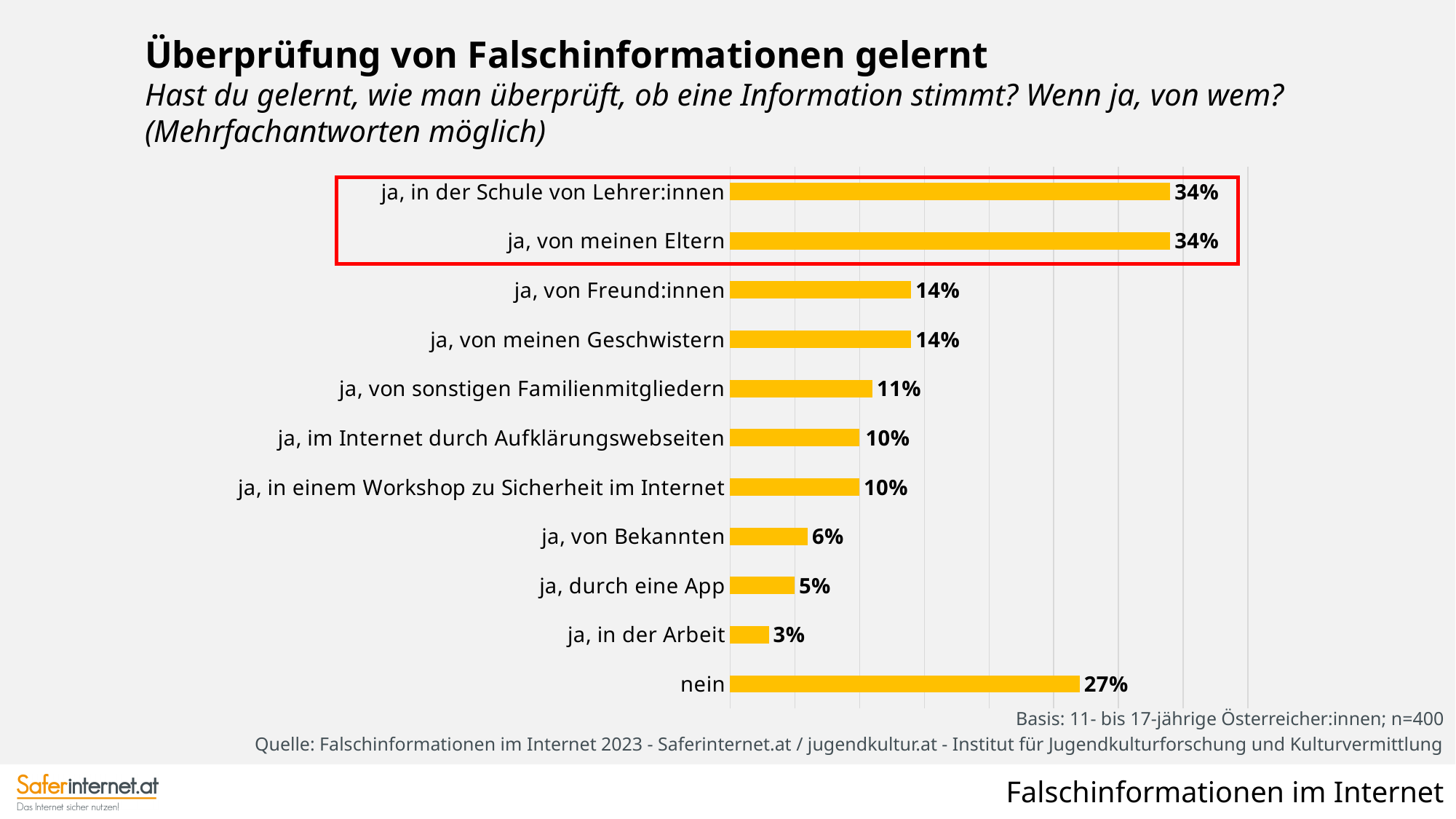
What kind of chart is shown on the slide? bar chart What is the value for "nein"? 27% What is the value for "ja, von Freund:innen"? 14% Which is larger, "nein" or "ja, in der Schule von Lehrer:innen"? ja, in der Schule von Lehrer:innen What colour are the bars in the chart? yellow What is the difference between "ja, von meinen Eltern" and "ja, von Bekannten"? 28% What is the value for "ja, von sonstigen Familienmitgliedern"? 11% How many categories are shown in the chart? 11 What is the value for "ja, in der Arbeit"? 3% What is the difference between "nein" and "ja, durch eine App"? 22% Which is larger, "ja, von Freund:innen" or "ja, von Bekannten"? ja, von Freund:innen Which category has the lowest value? ja, in der Arbeit